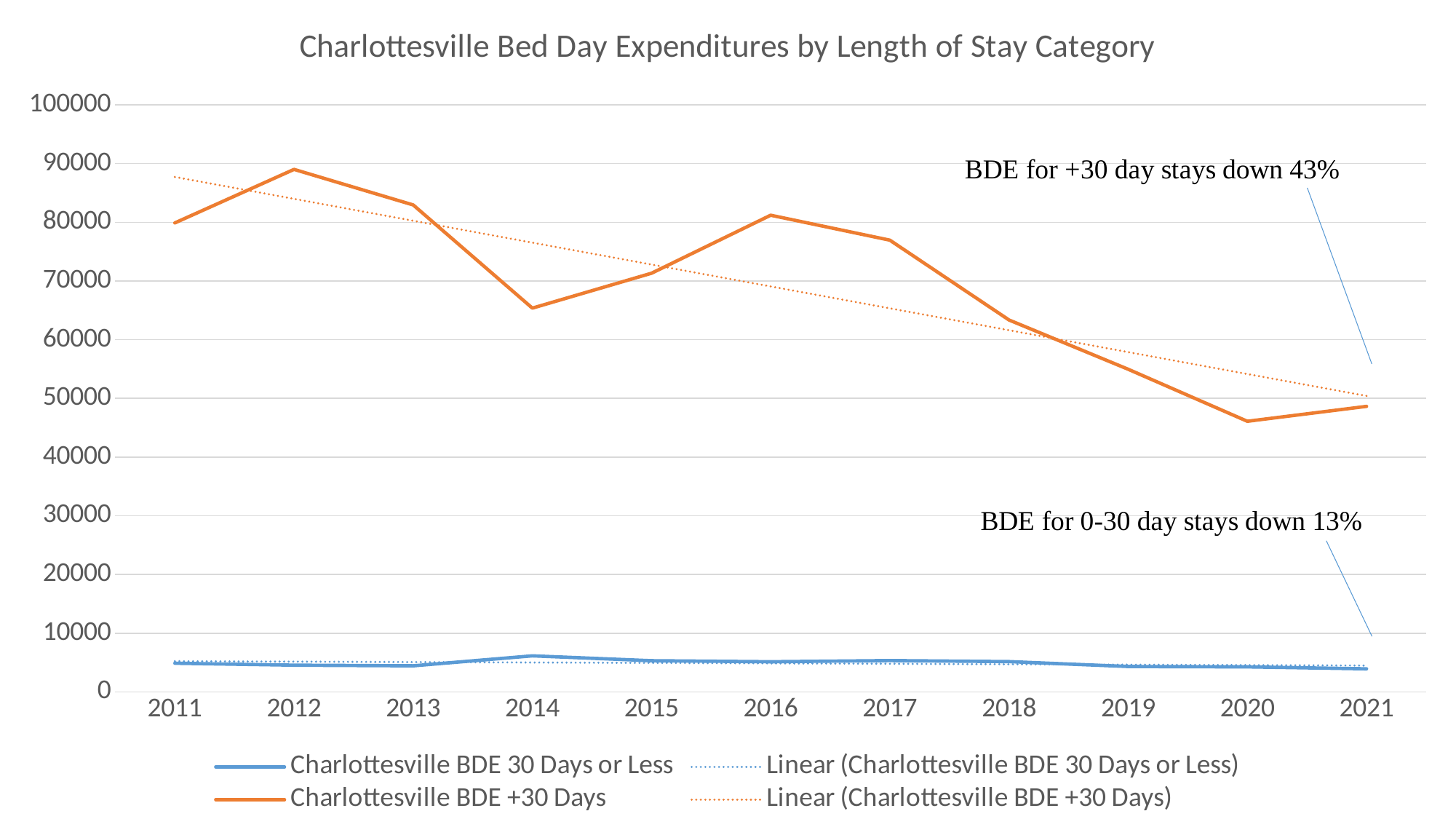
Overall, does the Charlottesville BDE +30 Days series rise or fall from 2011 to 2021? Fall In which year is the Charlottesville BDE +30 Days series highest? 2012 Is the value for Charlottesville BDE +30 Days in 2012 greater or less than 80000? greater Is the value for Charlottesville BDE +30 Days in 2020 greater or less than 50000? less Is the value for Charlottesville BDE +30 Days in 2014 greater or less than 70000? less What kind of chart is shown on the slide? Line chart What is the title of the chart? Charlottesville Bed Day Expenditures by Length of Stay Category How many years are shown on the x axis? 11 How many entries does the legend list? 4 According to the annotation on the chart, by what percentage is BDE for +30 day stays down? 43% Which is larger for Charlottesville BDE +30 Days: the value in 2016 or the value in 2020? 2016 In which year is the Charlottesville BDE +30 Days series lowest? 2020